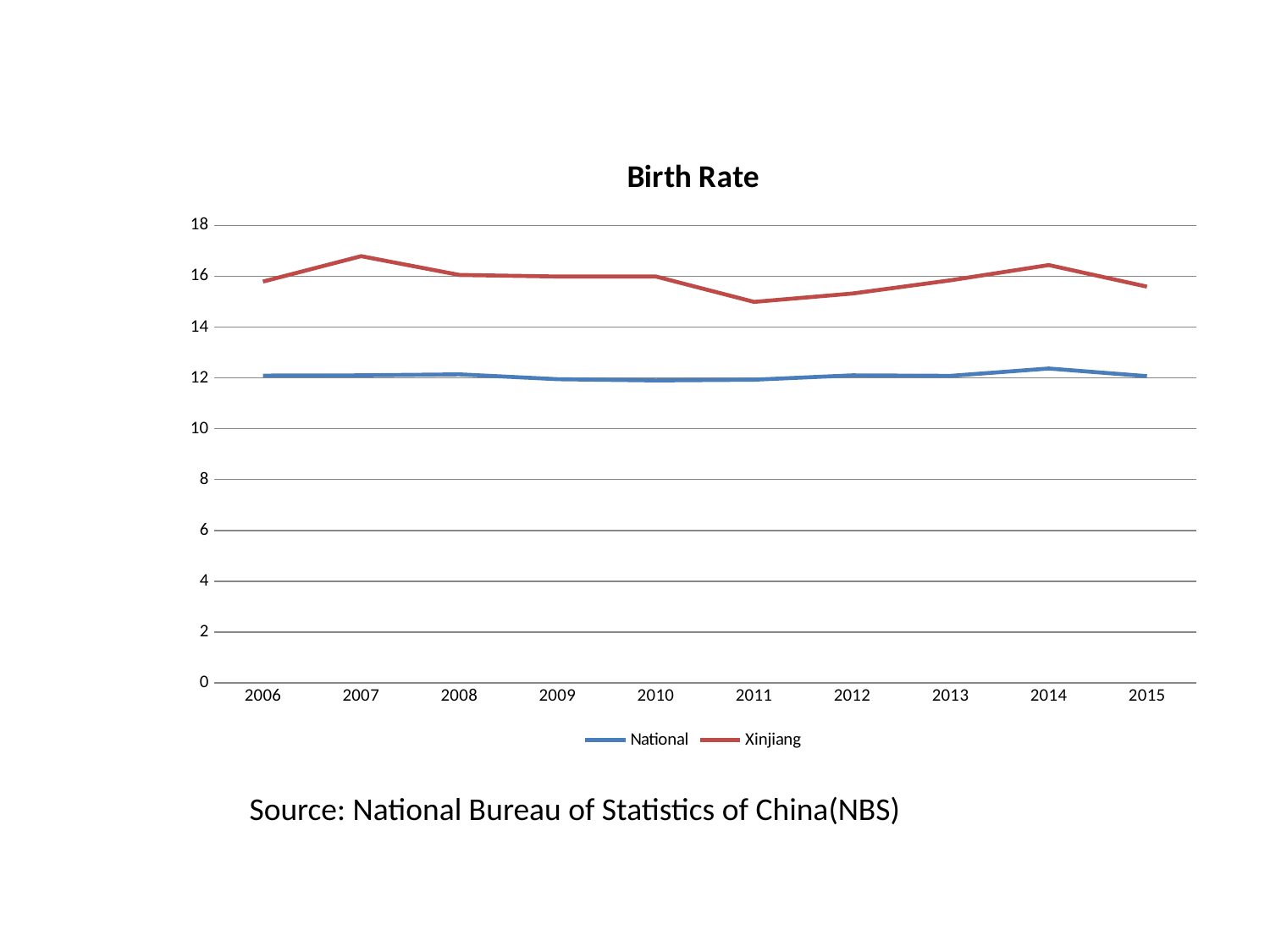
Is the Xinjiang value for 2007 greater or less than 16? greater Which series has the higher value in 2010, National or Xinjiang? Xinjiang Is the Xinjiang value for 2011 greater or less than 16? less Is the National value for 2010 greater or less than 14? less How many series does the legend list? 2 In which year is the National birth rate highest? 2014 How many years are shown on the x axis? 10 In which year is the Xinjiang birth rate highest? 2007 Does the Xinjiang birth rate rise or fall from 2007 to 2011? Fall What type of chart is shown on the slide? Line chart What is the title of the chart? Birth Rate In which year is the Xinjiang birth rate lowest? 2011